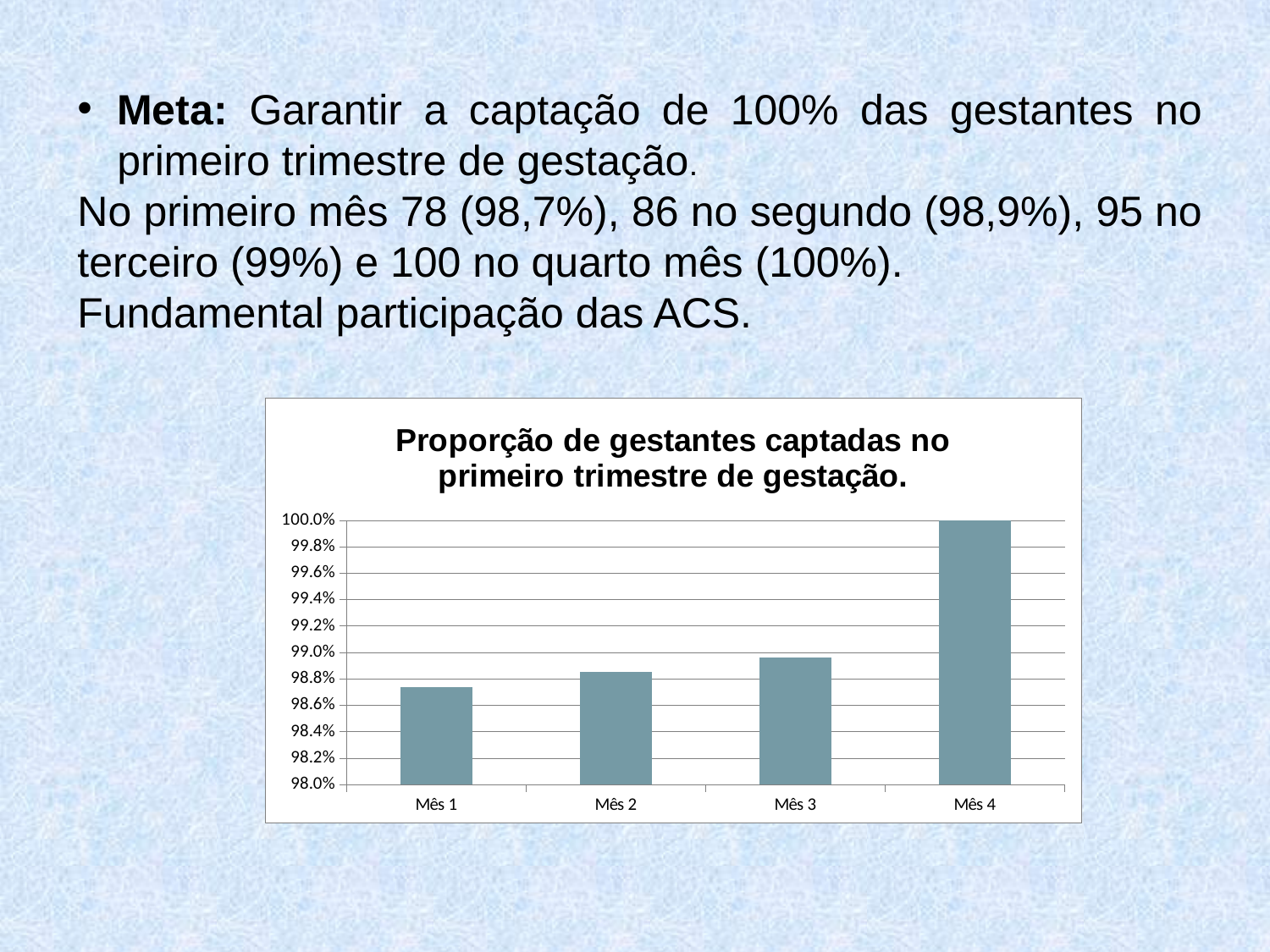
What kind of chart is shown on the slide? bar chart Which month has the lowest proportion in the chart? Mês 1 Is the value for Mês 3 greater or less than 98.8%? greater Do the values rise or fall from Mês 1 to Mês 4? rise Which month has the highest proportion in the chart? Mês 4 Which is larger, the value for Mês 1 or the value for Mês 3? Mês 3 What is the title of the chart? Proporção de gestantes captadas no primeiro trimestre de gestação. What is the value for Mês 4 in the chart? 100.0% How many categories (months) are plotted on the x axis of the chart? 4 Is the value for Mês 4 greater or less than 99.8%? greater Is the value for Mês 2 greater or less than 99.0%? less